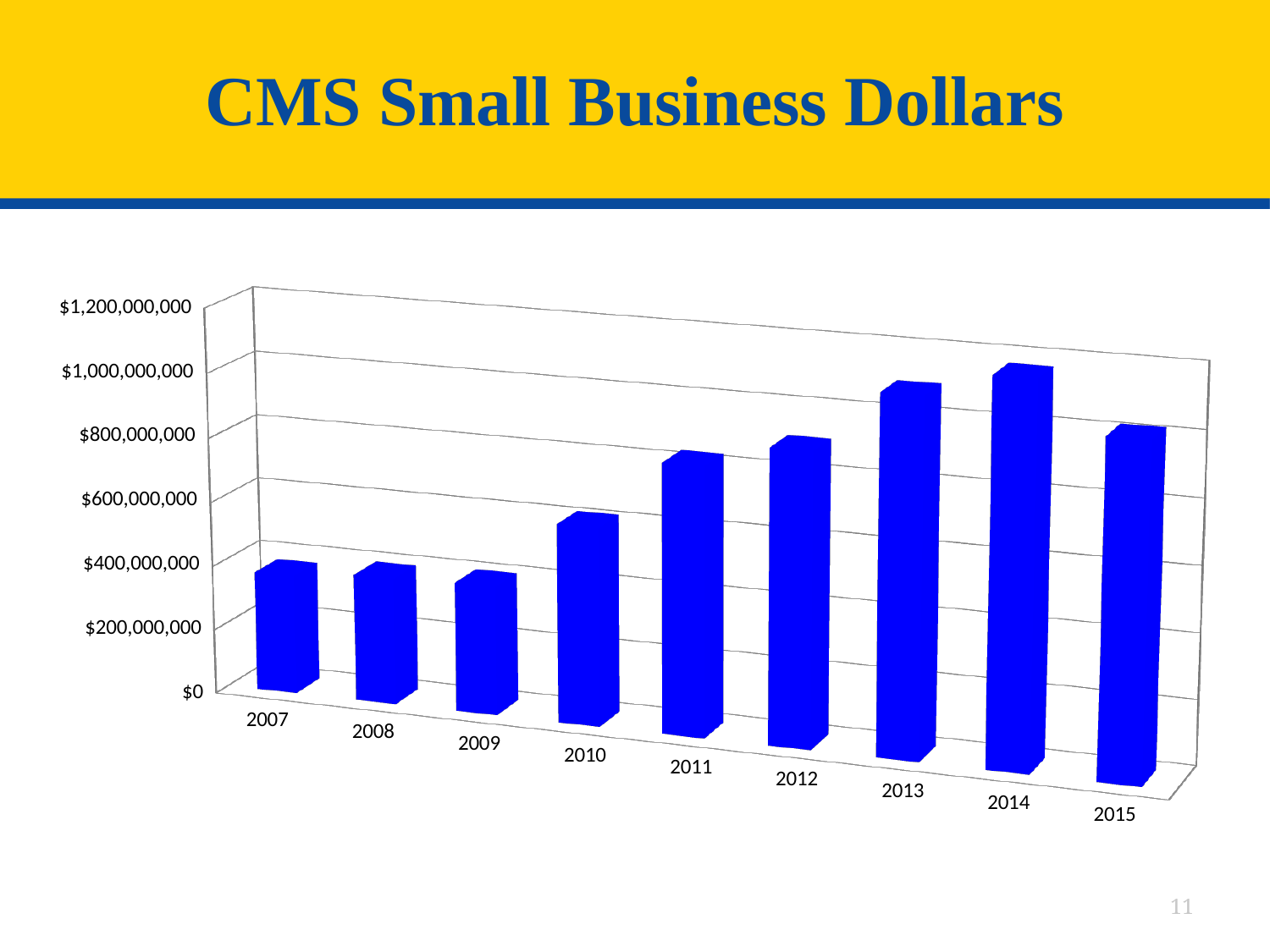
What is the highest value labelled on the vertical axis? $1,200,000,000 What is the title of the chart? CMS Small Business Dollars Which year has the larger value, 2009 or 2010? 2010 What kind of chart is shown on the slide? Bar chart Which year has the highest value in the chart? 2014 How many years are shown on the x axis of the chart? 9 Is the value for 2010 greater or less than $400,000,000? greater Do the values generally rise or fall from 2007 to 2014? rise Which year has the larger value, 2014 or 2015? 2014 Is the value for 2007 greater or less than $600,000,000? less Is the value for 2013 greater or less than $800,000,000? greater